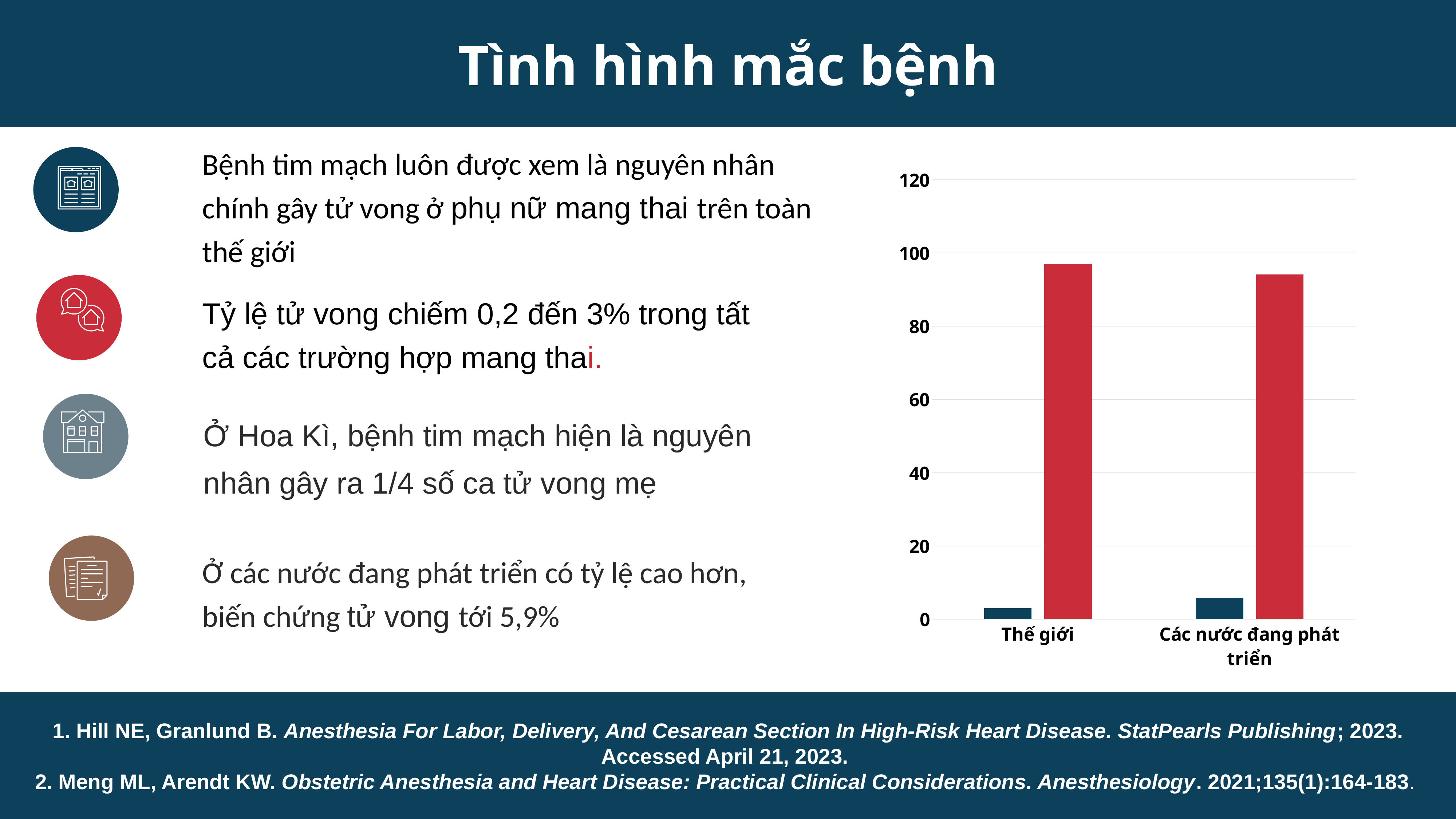
Is the red bar for Thế giới greater or less than 100? less How many categories are shown on the x axis of the bar chart? 2 Which category has the taller dark blue bar, Thế giới or Các nước đang phát triển? Các nước đang phát triển What are the two category labels on the x axis of the bar chart? Thế giới; Các nước đang phát triển Is the red bar for Thế giới greater or less than 80? greater Is the red bar for Các nước đang phát triển greater or less than 100? less What is the highest value shown on the y axis of the bar chart? 120 What kind of chart is shown on the right side of the slide? bar chart For Thế giới, which bar is taller, the red bar or the dark blue bar? the red bar